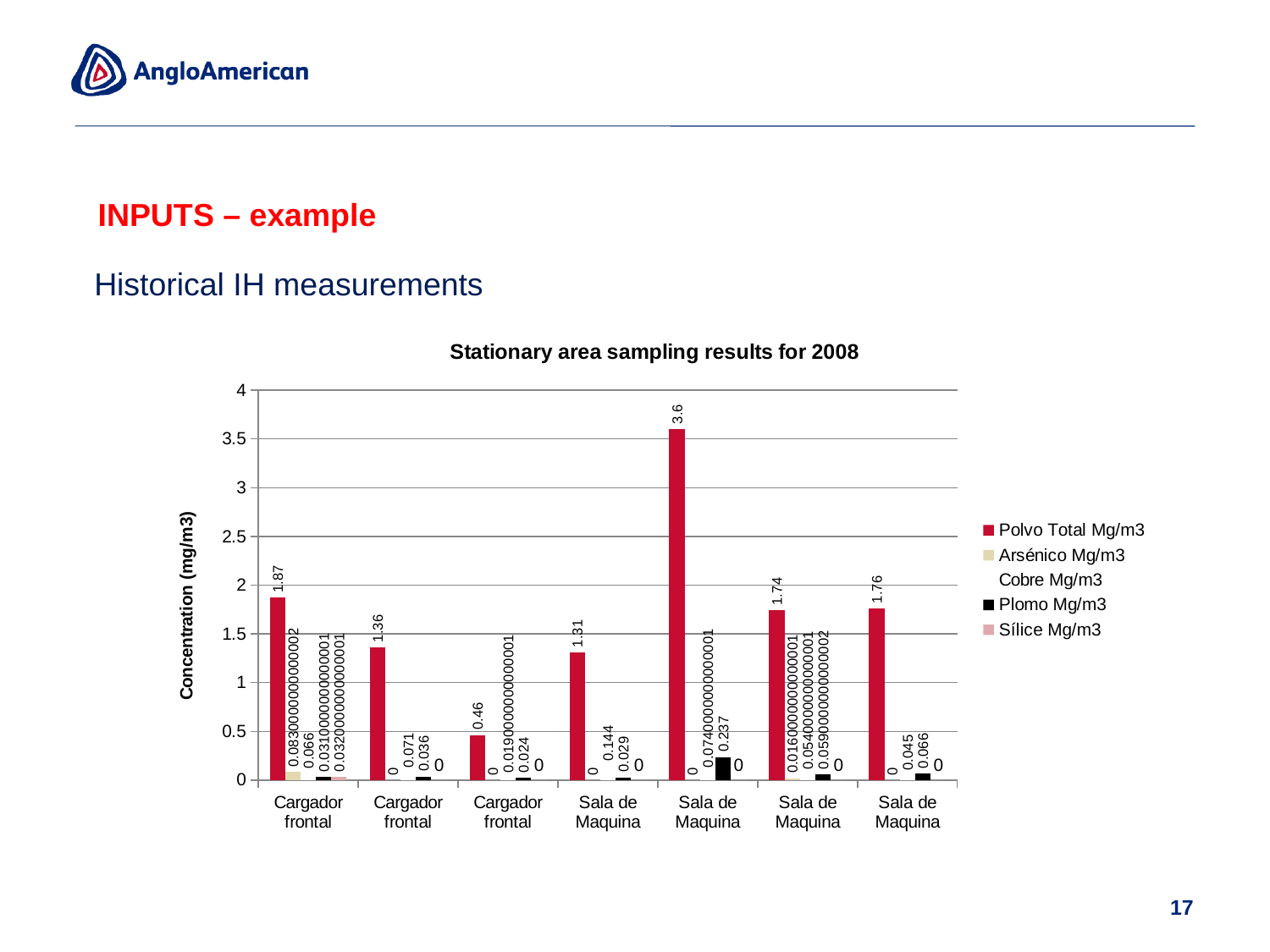
What is the highest Polvo Total Mg/m3 value shown in the chart? 3.6 What is the Polvo Total Mg/m3 value for the first Cargador frontal group? 1.87 Which group has the lowest Polvo Total Mg/m3 value? the third Cargador frontal group (0.46) What is the title of the chart? Stationary area sampling results for 2008 How many series does the legend list? 5 What type of chart is shown on the slide? bar chart What is the difference between the highest Polvo Total Mg/m3 value (3.6) and the Polvo Total value of the first Cargador frontal group (1.87)? 1.73 What is the Plomo Mg/m3 value for the second Sala de Maquina group (the one with Polvo Total of 3.6)? 0.237 How many category groups are shown along the x axis? 7 What is the label of the vertical axis? Concentration (mg/m3) What is the Polvo Total Mg/m3 value for the third Cargador frontal group? 0.46 Is the Polvo Total Mg/m3 value for the second Sala de Maquina group greater or less than 3.5? greater